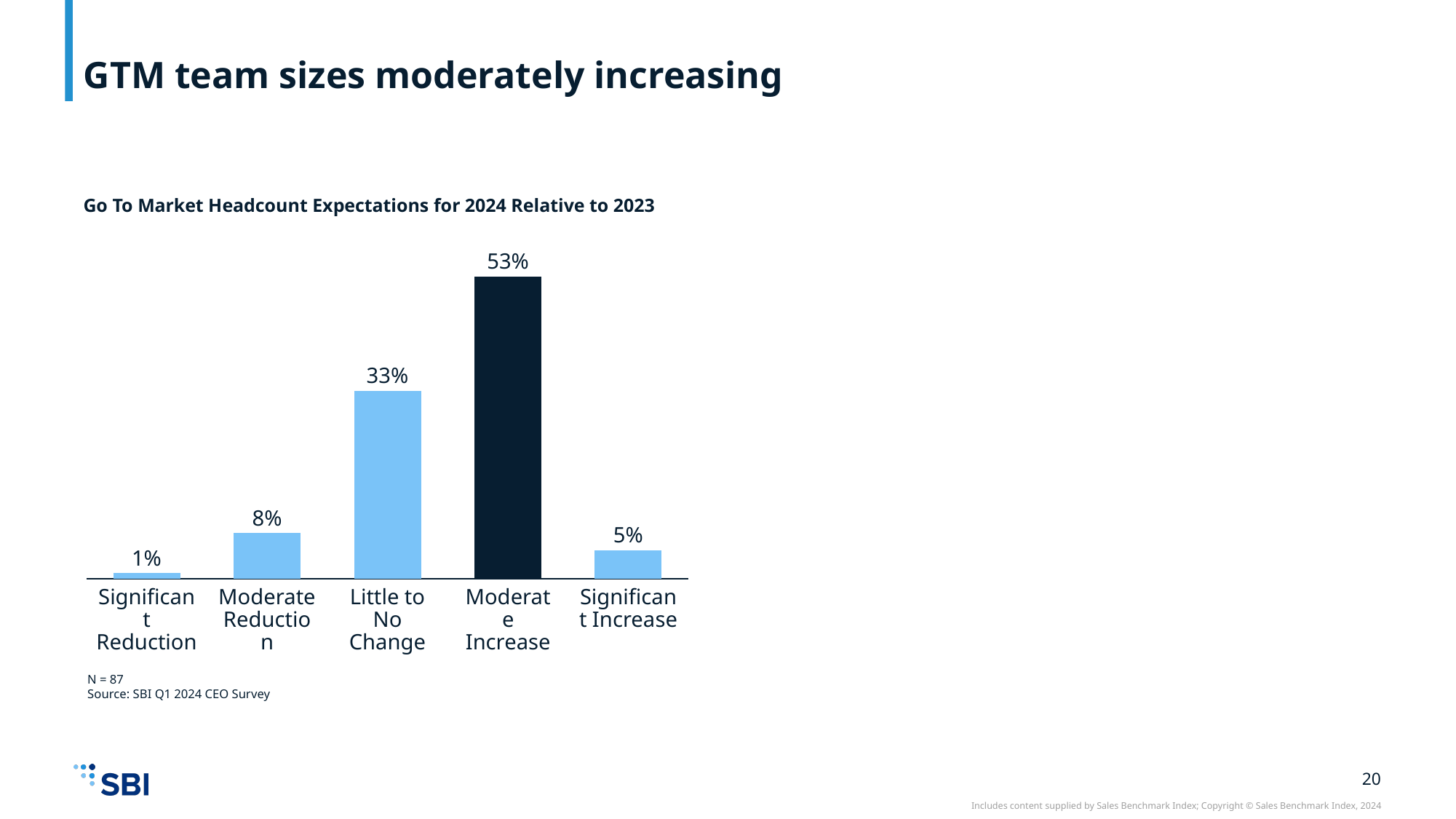
Which category has the lowest value in the chart? Significant Reduction What is the difference between the Moderate Increase and Little to No Change values? 20 percentage points How many categories are shown on the x axis of the chart? 5 Which is larger, the value for Moderate Reduction or the value for Significant Increase? Moderate Reduction What type of chart is shown on the slide? Bar chart What is the title of the chart? Go To Market Headcount Expectations for 2024 Relative to 2023 What is the value shown for Significant Increase? 5% What is the value shown for Significant Reduction? 1% What percentage of respondents expect Little to No Change in go-to-market headcount? 33% Which category has the highest value in the chart? Moderate Increase What percentage of respondents expect a Moderate Increase in go-to-market headcount for 2024? 53% What is the value shown for Moderate Reduction? 8%